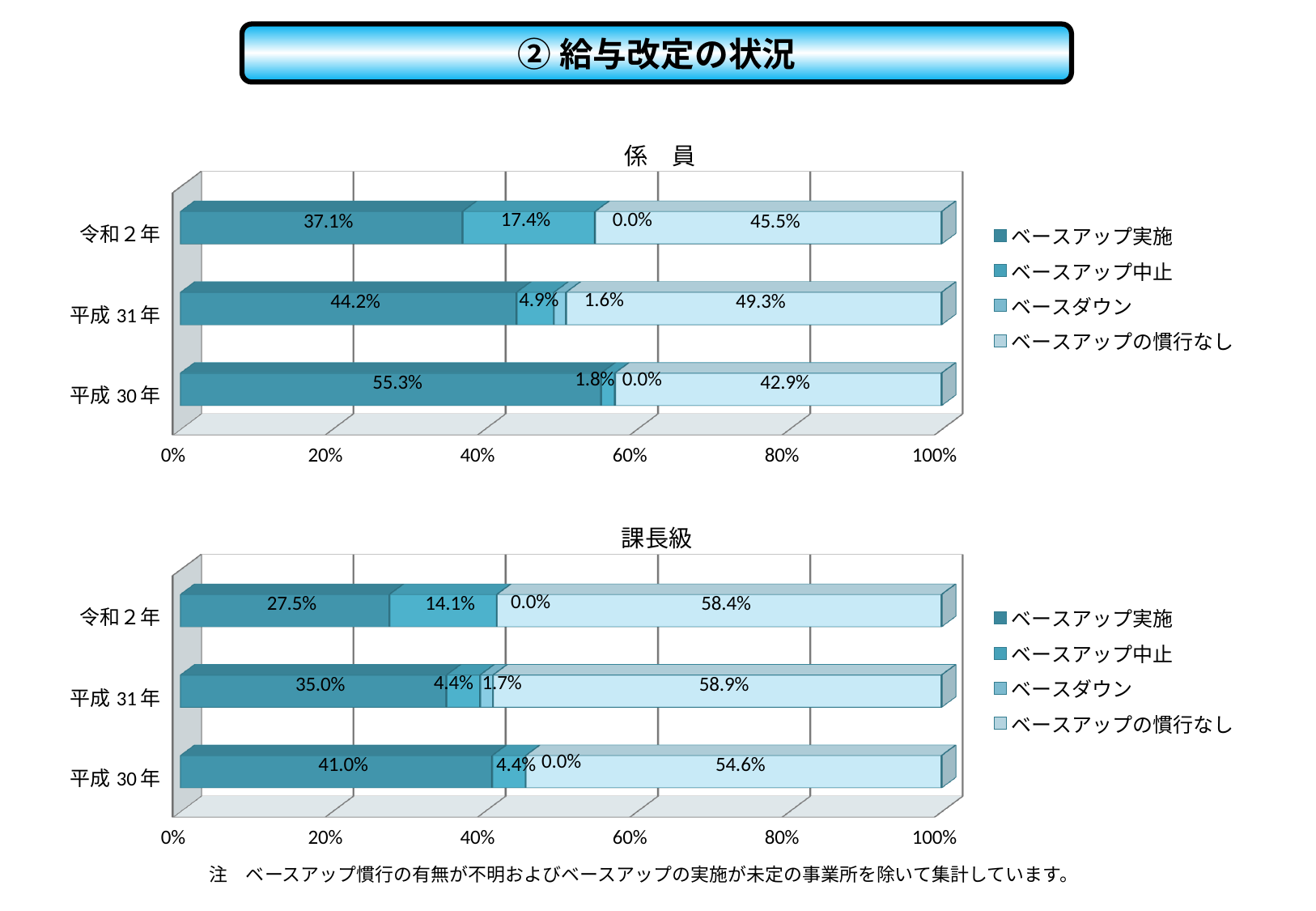
In the 係員 chart, what is the difference between the ベースアップ実施 values for 平成30年 and 令和２年? 18.2% What is the title of the bottom chart? 課長級 In the 課長級 chart, what is the value of ベースアップの慣行なし for 平成31年? 58.9% In the 係員 chart, what is the value of ベースアップ実施 for 令和２年? 37.1% In the 係員 chart, what is the value of ベースアップ中止 for 平成30年? 1.8% In the 課長級 chart, what is the value of ベースダウン for 平成31年? 1.7% What type of chart is the 係員 chart? Stacked bar chart In the 係員 chart, which year has the highest value for ベースアップ実施? 平成30年 How many series does the legend of the 係員 chart list? 4 In the 課長級 chart, which year has the lowest value for ベースアップ実施? 令和２年 How many years (categories) are shown in the 課長級 chart? 3 In the 課長級 chart, which is larger for 令和２年: ベースアップ中止 or ベースアップの慣行なし? ベースアップの慣行なし